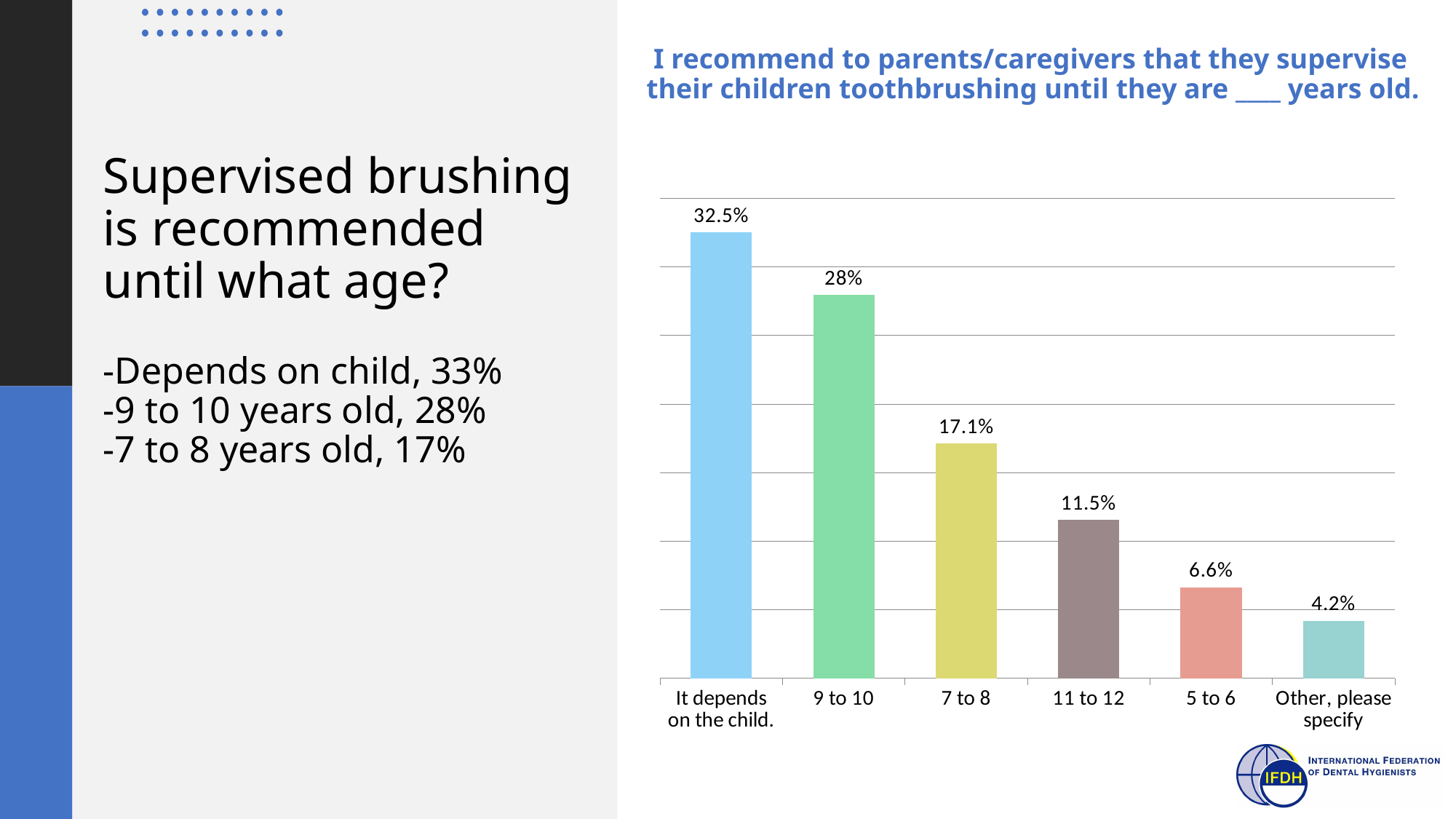
How many categories are shown on the chart? 6 Do the values rise or fall from left to right across the categories? Fall What is the value shown for the "11 to 12" category? 11.5% Which category has the lowest value? Other, please specify What is the difference between the values for "9 to 10" and "7 to 8"? 10.9% What percentage of respondents answered "It depends on the child."? 32.5% Which is larger, the value for "7 to 8" or the value for "11 to 12"? 7 to 8 What kind of chart is shown on the slide? Bar chart What is the difference between the values for "5 to 6" and "Other, please specify"? 2.4% Which category has the highest value? It depends on the child. What is the value shown for the "Other, please specify" category? 4.2% What is the value shown for the "9 to 10" category? 28%